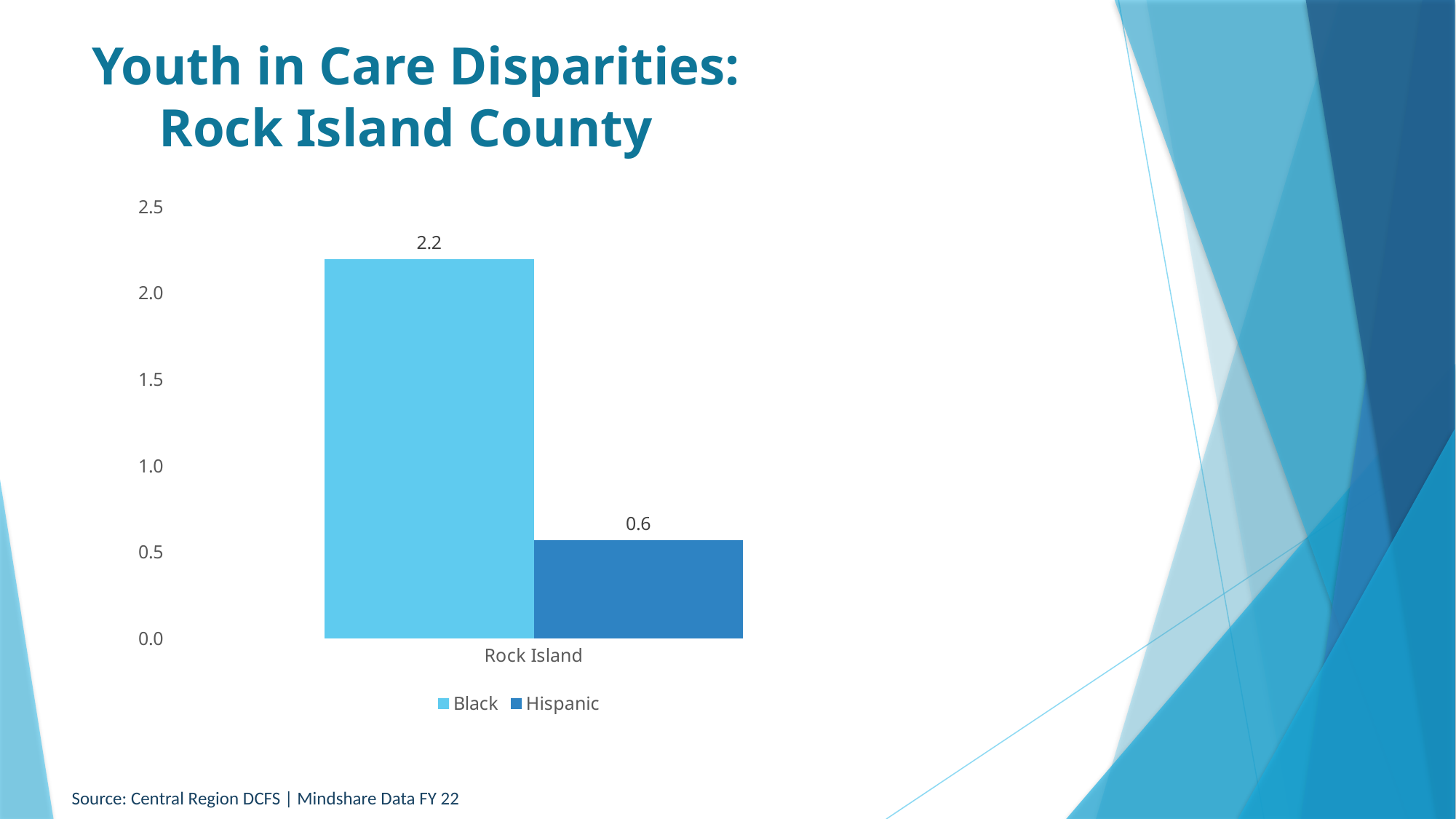
What kind of chart is shown on the slide? Bar chart What is the highest value shown on the y axis? 2.5 Is the value for Black in Rock Island greater or less than 2.0? greater Which series has the lowest value in the chart? Hispanic Is the value for Hispanic in Rock Island greater or less than 1.0? less Which series has the higher value for Rock Island, Black or Hispanic? Black Which series has the highest value in the chart? Black How many categories are shown on the x axis? 1 How many series does the legend list? 2 What is the value for Hispanic in Rock Island? 0.6 What is the value for Black in Rock Island? 2.2 What is the difference between the Black and Hispanic values for Rock Island? 1.6